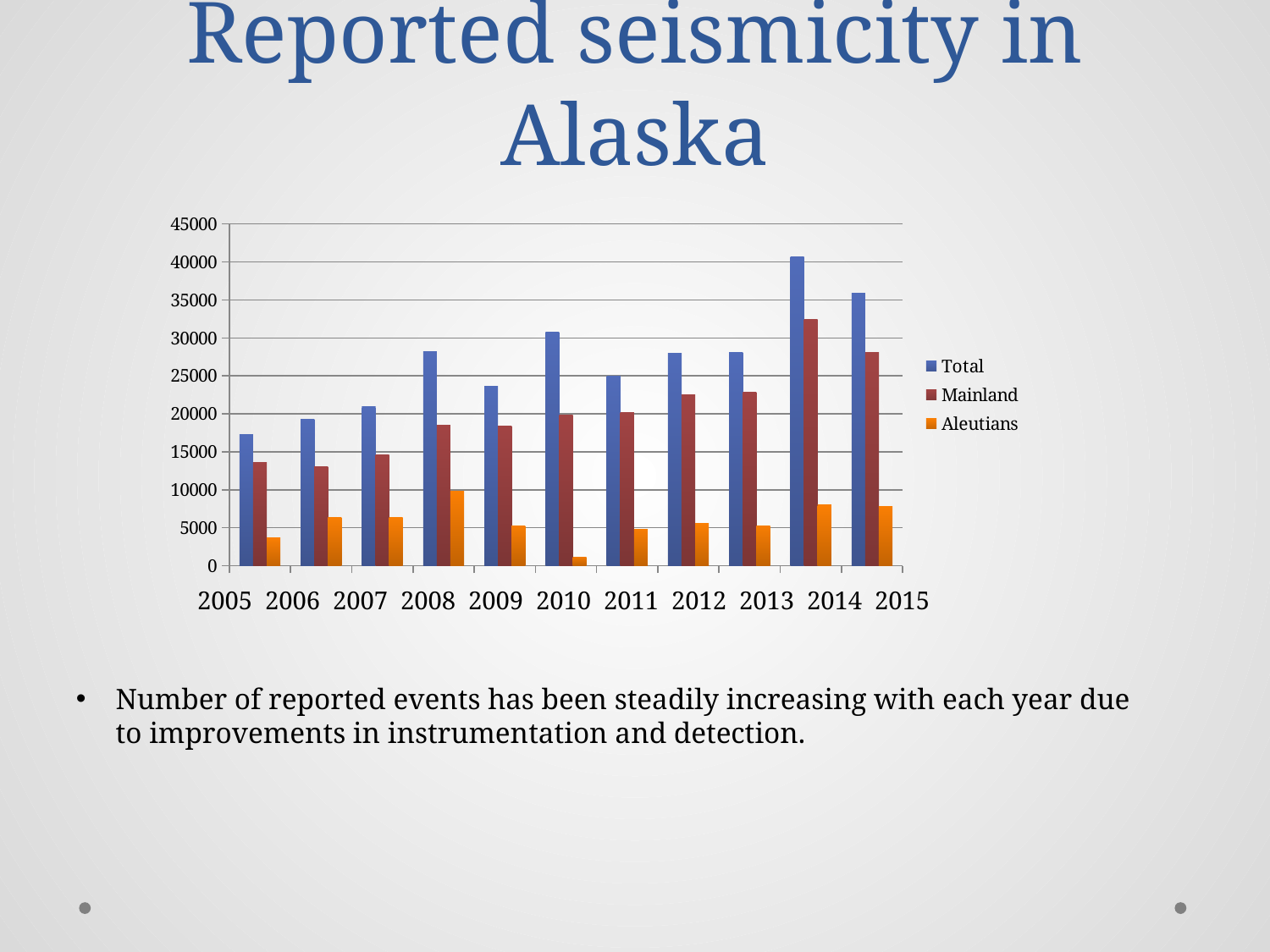
In which year is the Aleutians series highest? 2008 Is the Mainland value for 2014 greater or less than 30000? greater Which is larger, the Total value for 2014 or the Total value for 2015? 2014 Overall, does the Total series rise or fall from 2005 to 2015? rise Is the Total value for 2014 greater or less than 35000? greater How many years are shown on the x axis? 11 How many series does the legend list? 3 What kind of chart is shown on the slide? bar chart In which year is the Total series highest? 2014 Is the Aleutians value for 2010 greater or less than 5000? less In which year is the Aleutians series lowest? 2010 In which year is the Total series lowest? 2005